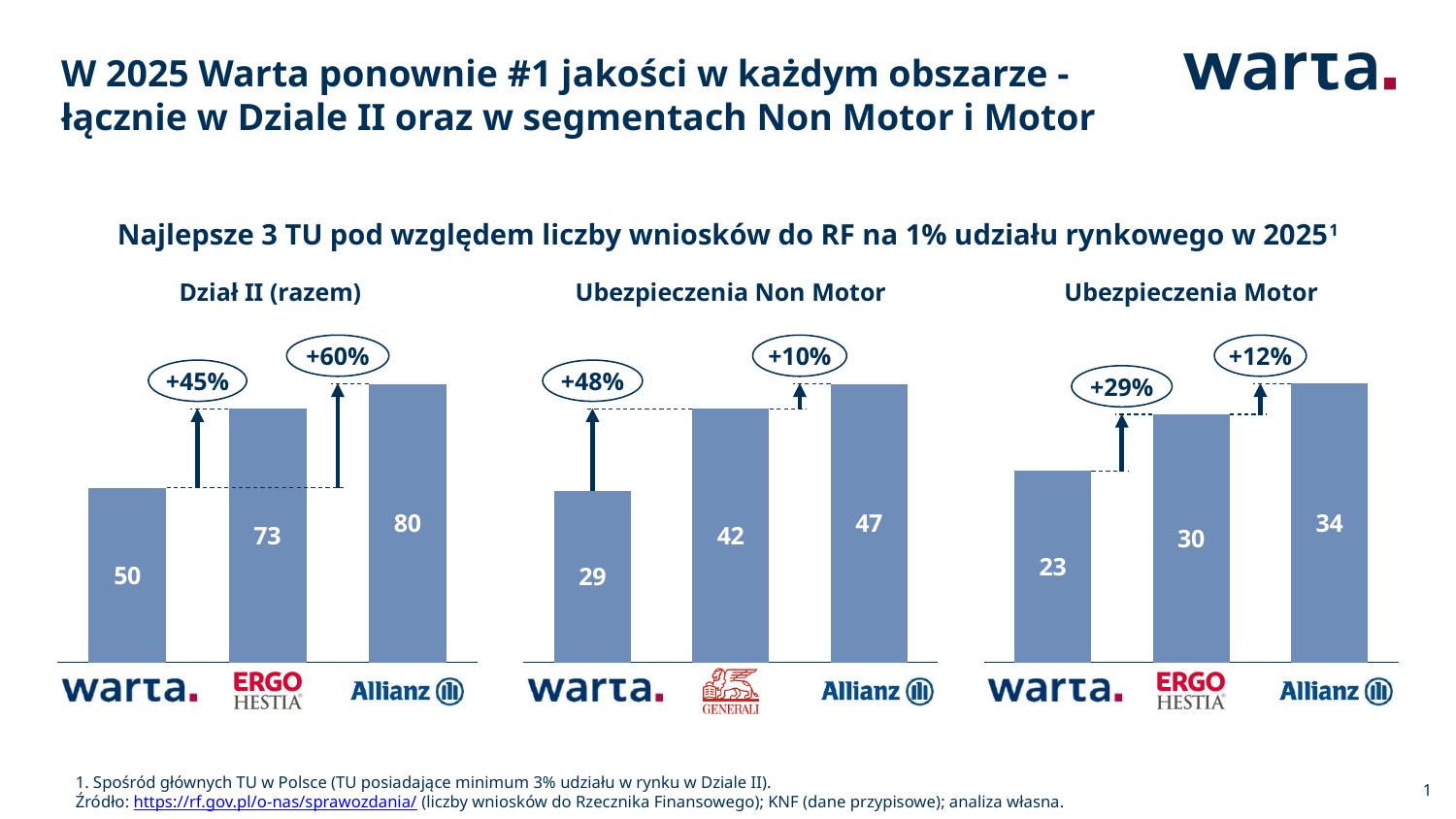
In the 'Dział II (razem)' chart, what is the value for Warta? 50 What kind of chart is the 'Dział II (razem)' chart? Bar chart In the 'Dział II (razem)' chart, what is the difference between the values for Allianz and Warta? 30 In the 'Ubezpieczenia Motor' chart, which insurer has the lowest value? Warta In the 'Ubezpieczenia Motor' chart, what is the difference between the values for Allianz and Ergo Hestia? 4 In the 'Ubezpieczenia Motor' chart, what is the value for Ergo Hestia? 30 How many bars are shown in the 'Ubezpieczenia Motor' chart? 3 In the 'Ubezpieczenia Non Motor' chart, what is the value for Generali? 42 In the 'Dział II (razem)' chart, what is the value for Allianz? 80 In the 'Ubezpieczenia Non Motor' chart, what percentage is shown above the arrow between Warta and Generali? +48% In the 'Ubezpieczenia Non Motor' chart, which insurer has the highest value? Allianz In the 'Ubezpieczenia Non Motor' chart, which is larger, the value for Warta or the value for Generali? Generali